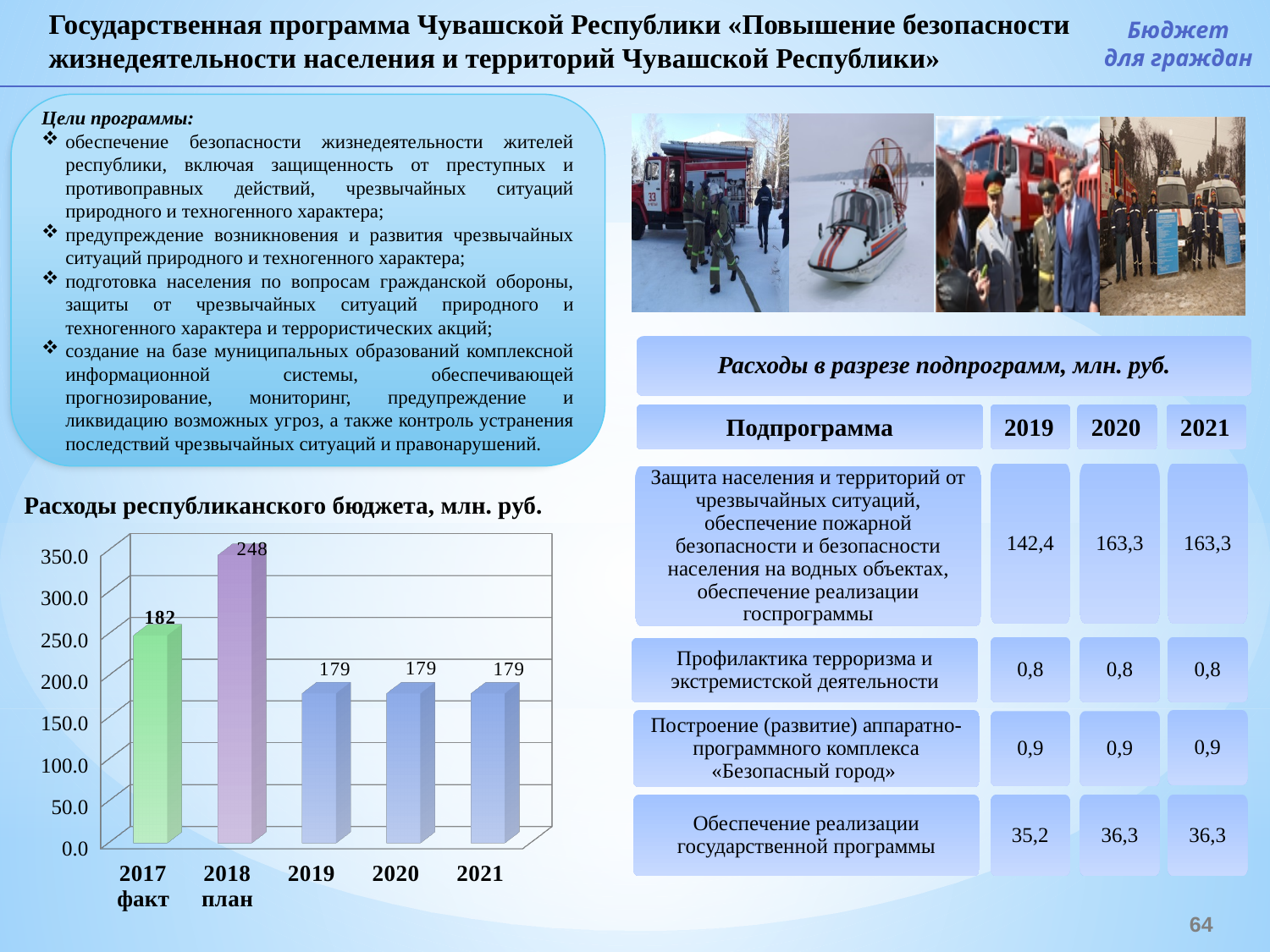
Is the value for 2019 in the chart «Расходы республиканского бюджета, млн. руб.» greater or less than 200.0? less How many bars are shown in the chart «Расходы республиканского бюджета, млн. руб.»? 5 In the chart «Расходы республиканского бюджета, млн. руб.», do the values rise, fall or stay the same from 2019 to 2021? stay the same What kind of chart is «Расходы республиканского бюджета, млн. руб.»? bar chart What is the value for 2020 in the chart «Расходы республиканского бюджета, млн. руб.»? 179 Which is larger in the chart «Расходы республиканского бюджета, млн. руб.»: the value for 2017 факт or the value for 2021? 2017 факт What is the value for 2018 план in the chart «Расходы республиканского бюджета, млн. руб.»? 248 Which year has the highest value in the chart «Расходы республиканского бюджета, млн. руб.»? 2018 план What is the difference between the values for 2018 план and 2017 факт in the chart «Расходы республиканского бюджета, млн. руб.»? 66 What is the difference between the values for 2017 факт and 2019 in the chart «Расходы республиканского бюджета, млн. руб.»? 3 Is the value for 2018 план in the chart «Расходы республиканского бюджета, млн. руб.» greater or less than 200.0? greater What is the value for 2017 факт in the chart «Расходы республиканского бюджета, млн. руб.»? 182